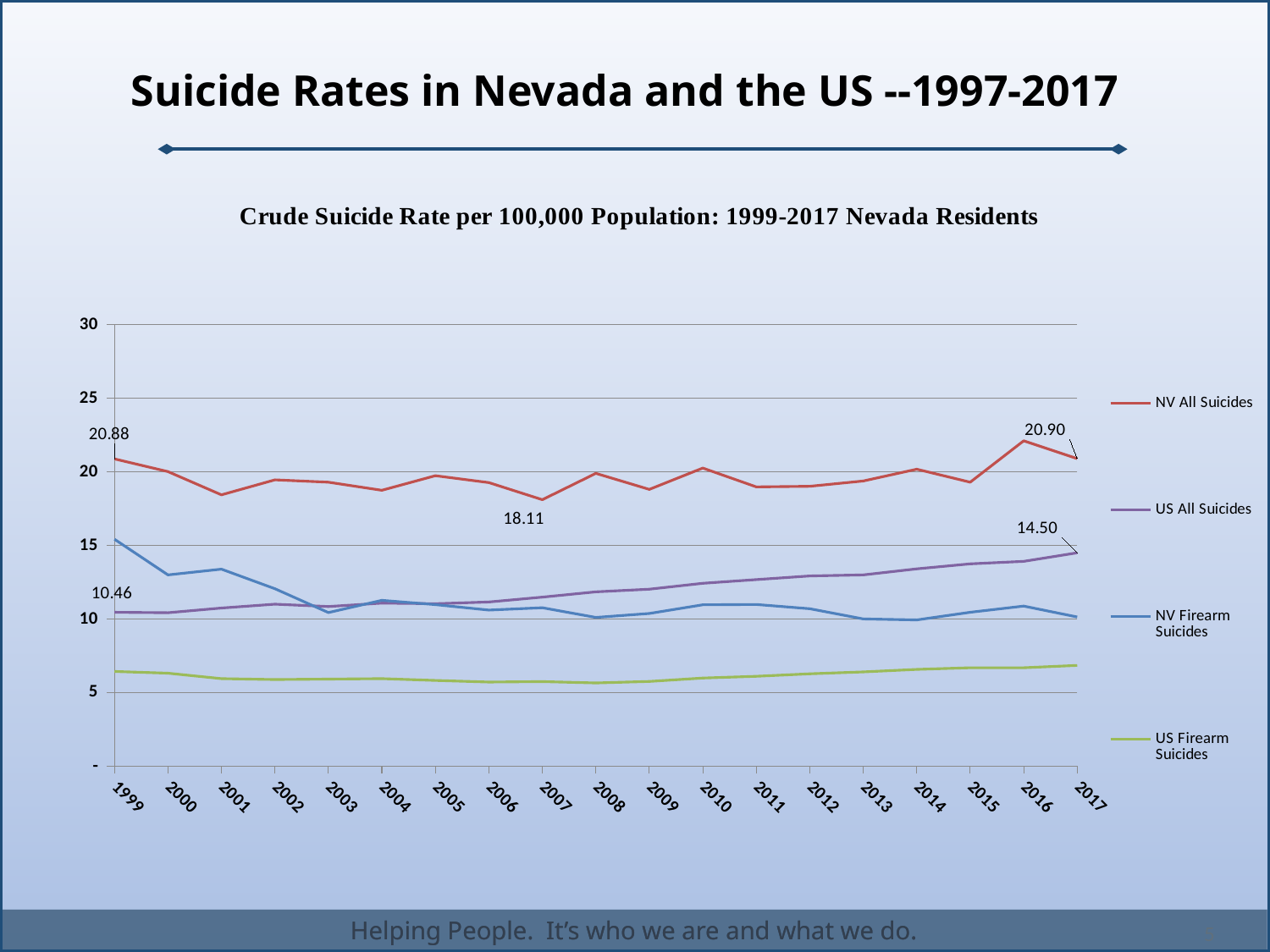
How many series does the legend list? 4 How many years are plotted along the x axis? 19 Is the US Firearm Suicides value in 2017 greater or less than 10? less What is the NV All Suicides rate in 1999? 20.88 Does the US All Suicides series rise or fall from 1999 to 2017? rise What is the NV All Suicides rate in 2017? 20.90 What is the US All Suicides rate in 1999? 10.46 What is the difference between the NV All Suicides rate and the US All Suicides rate in 2017? 6.40 What kind of chart is shown on the slide? line chart What is the US All Suicides rate in 2017? 14.50 What is the NV All Suicides rate in 2007? 18.11 Which series has the highest values across the whole period? NV All Suicides